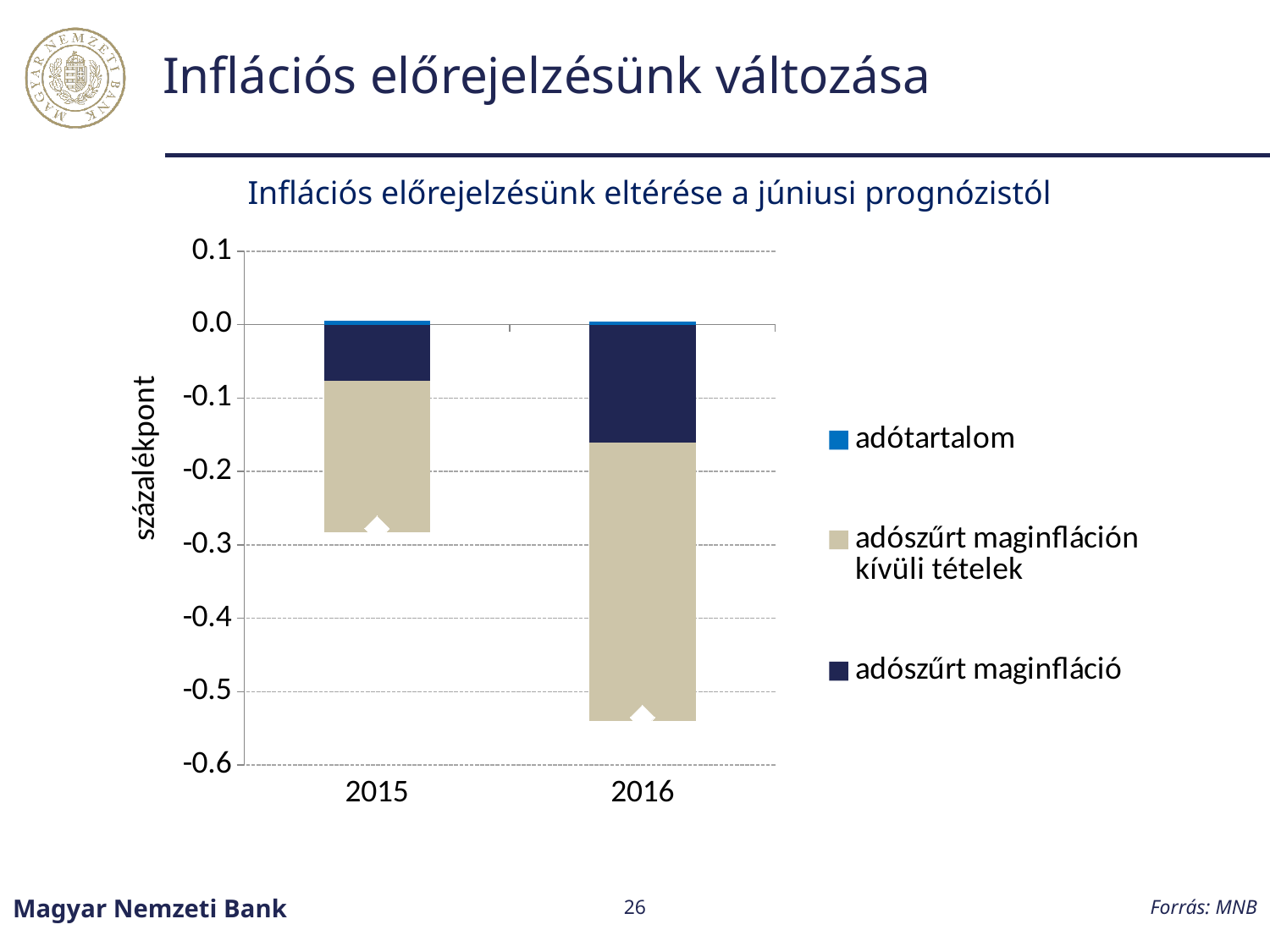
What is the title of the chart? Inflációs előrejelzésünk eltérése a júniusi prognózistól What is the label of the vertical axis of the chart? százalékpont Is the value of the 'adószűrt maginfláció' segment for 2016 greater or less than -0.2? greater Is the total value of the stacked bar for 2016 greater or less than -0.5? less How many years (categories) are shown on the x axis of the chart? 2 Which year has the larger 'adószűrt maginfláción kívüli tételek' segment in absolute size, 2015 or 2016? 2016 Is the total value of the stacked bar for 2015 greater or less than -0.2? less What kind of chart is shown on the slide? stacked bar chart Do the total stacked bar values rise or fall from 2015 to 2016? fall Which year has the lower (more negative) total stacked bar, 2015 or 2016? 2016 How many series does the chart legend list? 3